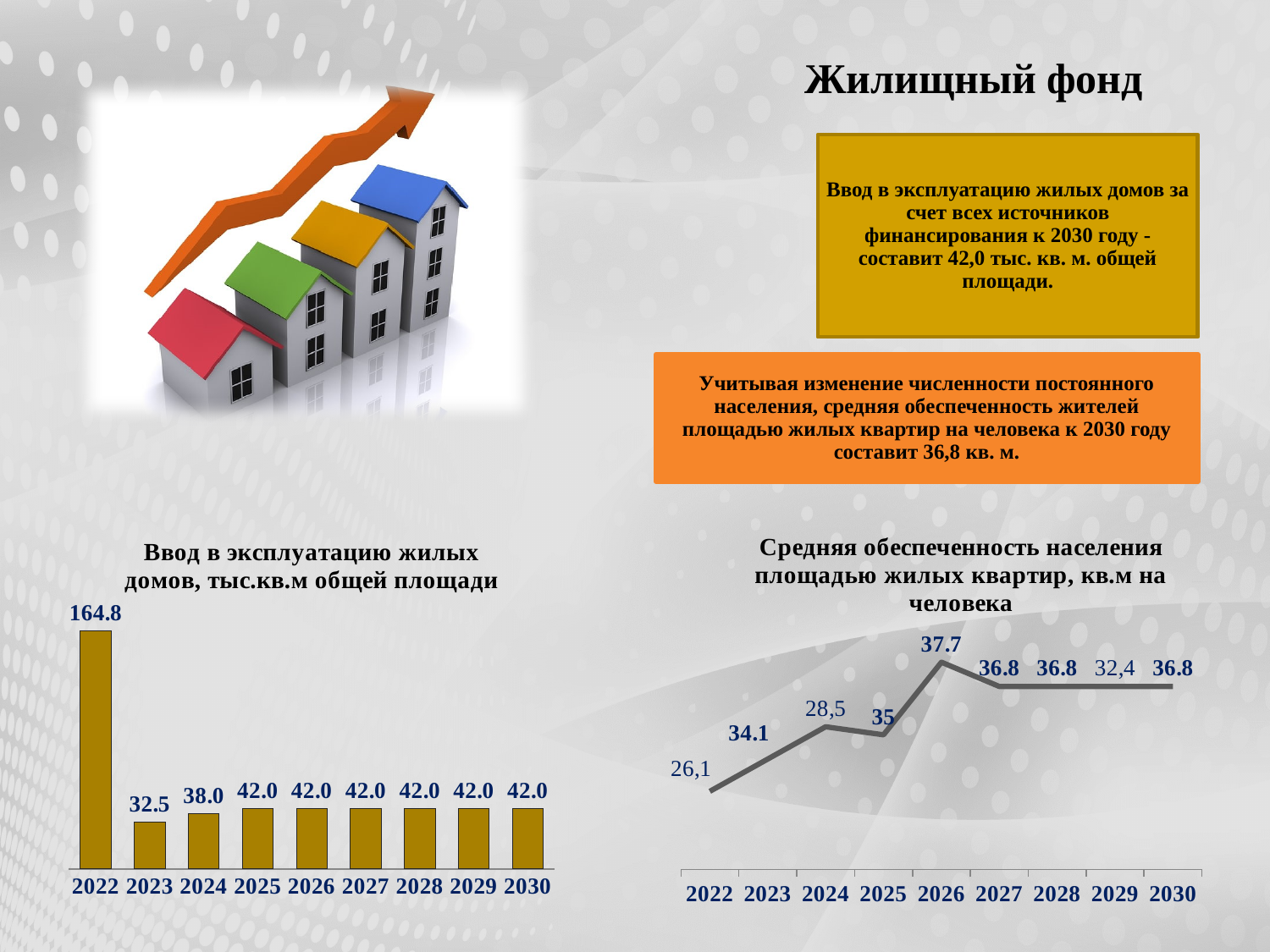
What kind of chart is the left chart (Ввод в эксплуатацию жилых домов)? bar chart On the right chart (Средняя обеспеченность населения), what is the value for 2022? 26,1 On the left chart (Ввод в эксплуатацию жилых домов), what is the value for 2022? 164.8 On the left chart (Ввод в эксплуатацию жилых домов), which year has the highest value? 2022 On the right chart (Средняя обеспеченность населения), what is the value for 2026? 37.7 On the left chart (Ввод в эксплуатацию жилых домов), what is the difference between the values for 2022 and 2023? 132.3 On the left chart (Ввод в эксплуатацию жилых домов), what is the value for 2024? 38.0 On the right chart (Средняя обеспеченность населения), which year has the highest labelled value? 2026 What kind of chart is the right chart (Средняя обеспеченность населения)? line chart On the left chart (Ввод в эксплуатацию жилых домов), how many years are shown on the x axis? 9 On the left chart (Ввод в эксплуатацию жилых домов), which year has the lowest value? 2023 On the left chart (Ввод в эксплуатацию жилых домов), what is the value for 2023? 32.5